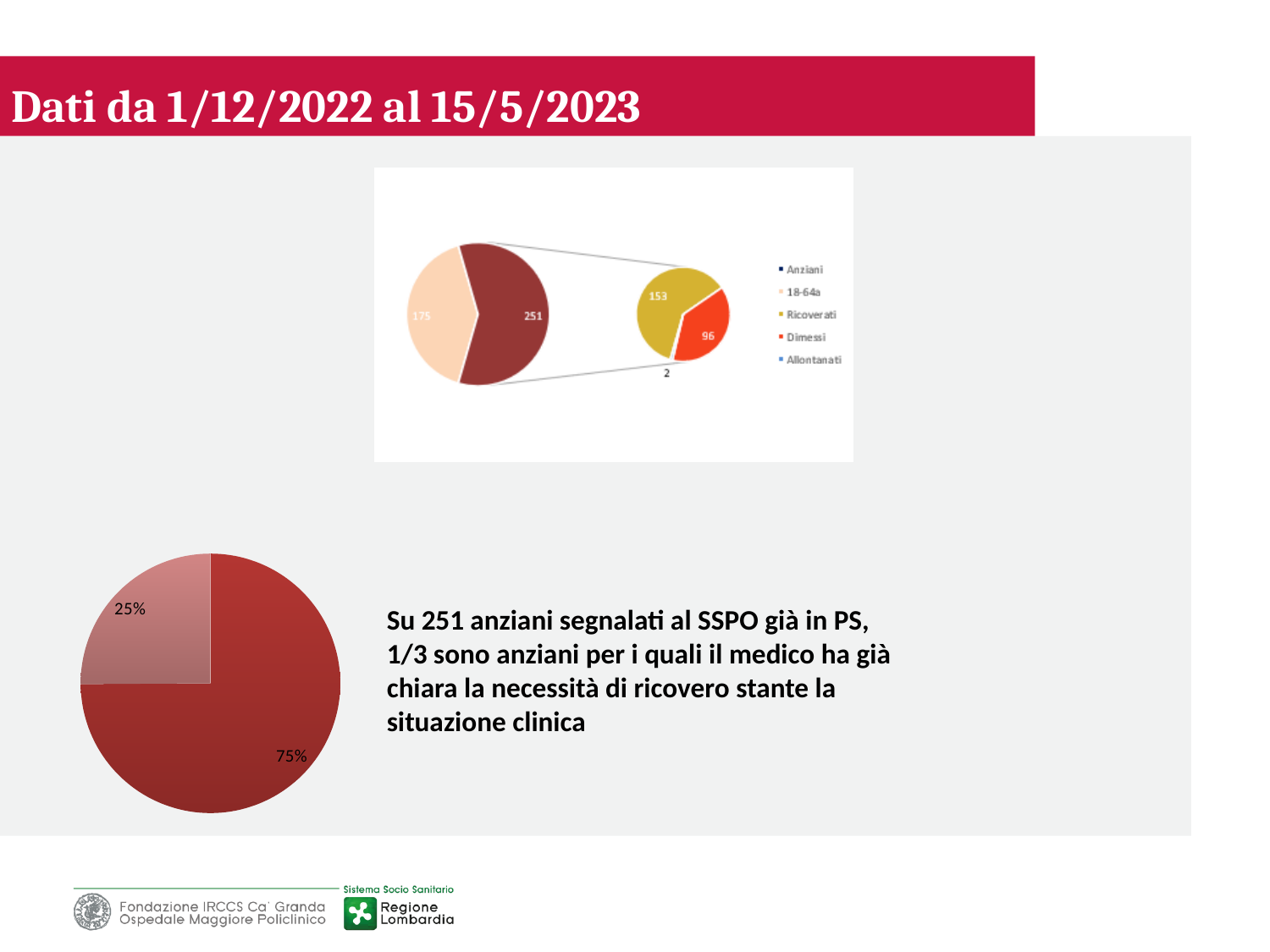
In the top pie-of-pie chart, what is the value for 18-64a? 175 In the top pie-of-pie chart, what is the difference between Anziani and 18-64a? 76 In the top pie-of-pie chart, which category has the smallest value? Allontanati In the top pie-of-pie chart, what is the value for Allontanati? 2 In the bottom-left pie chart, what share does the smaller slice represent? 25% How many entries does the legend of the top pie-of-pie chart list? 5 In the bottom-left pie chart, what share does the larger slice represent? 75% What kind of chart is shown at the bottom left of the slide? Pie chart In the top pie-of-pie chart, which is larger, Ricoverati or Dimessi? Ricoverati In the top pie-of-pie chart, what is the value for Dimessi? 96 In the top pie-of-pie chart, what is the value for Anziani? 251 In the top pie-of-pie chart, what is the value for Ricoverati? 153